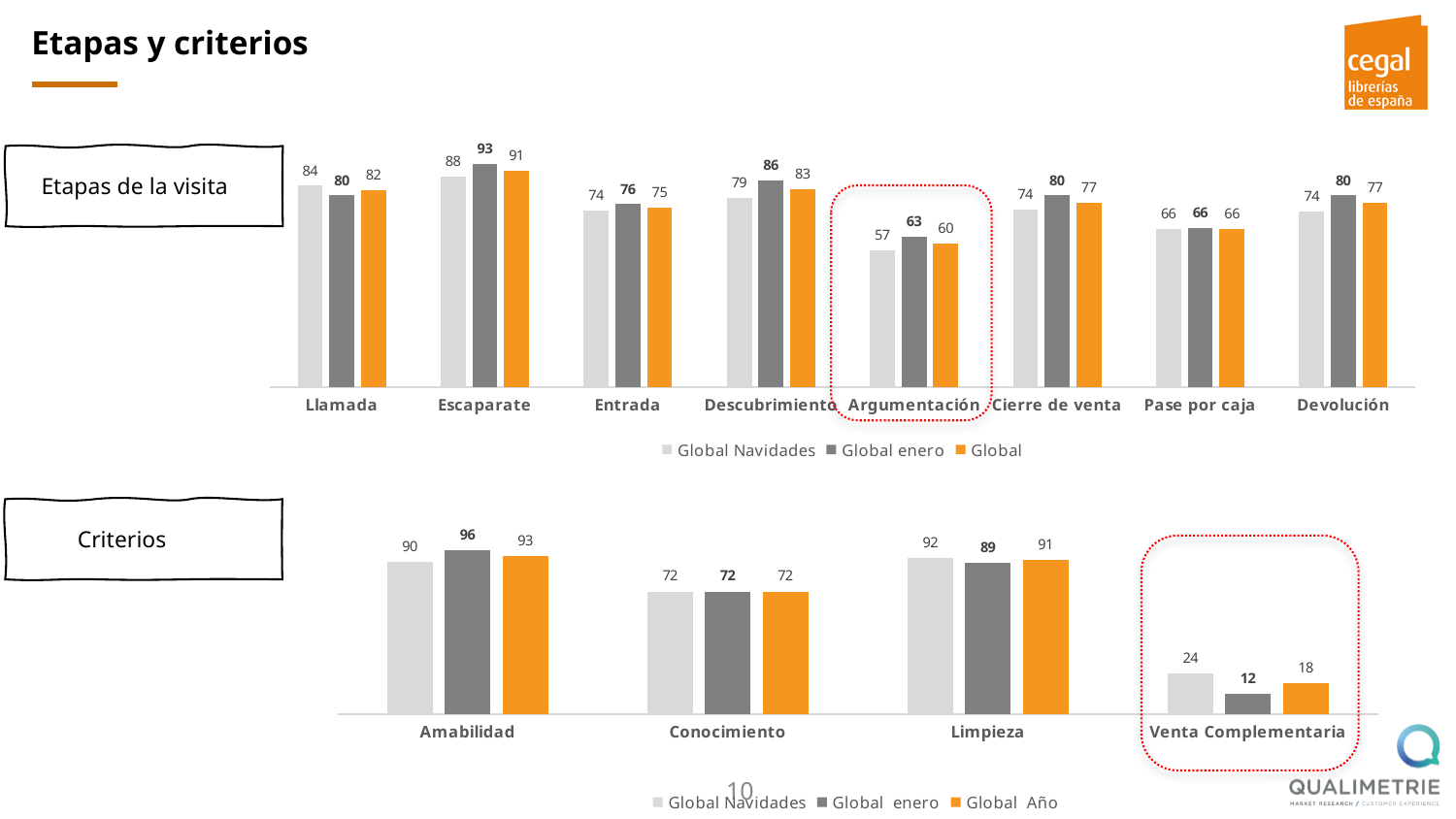
In the 'Etapas de la visita' chart, what is the Global Navidades value for Argumentación? 57 In the 'Criterios' chart, what is the difference between the Global Navidades and Global Año values for Venta Complementaria? 6 What type of chart is the 'Criterios' chart? Bar chart In the 'Criterios' chart, which category has the highest Global enero value? Amabilidad In the 'Etapas de la visita' chart, what is the difference between the Global enero and Global Navidades values for Descubrimiento? 7 In the 'Etapas de la visita' chart, how many categories are shown on the x axis? 8 In the 'Etapas de la visita' chart, what is the Global enero value for Escaparate? 93 In the 'Criterios' chart, what is the Global enero value for Venta Complementaria? 12 In the 'Criterios' chart, what is the name of the third series in the legend? Global Año In the 'Etapas de la visita' chart, which category has the lowest Global enero value? Argumentación In the 'Etapas de la visita' chart, how many series does the legend list? 3 In the 'Criterios' chart, which is larger for Limpieza: the Global Navidades value or the Global enero value? Global Navidades